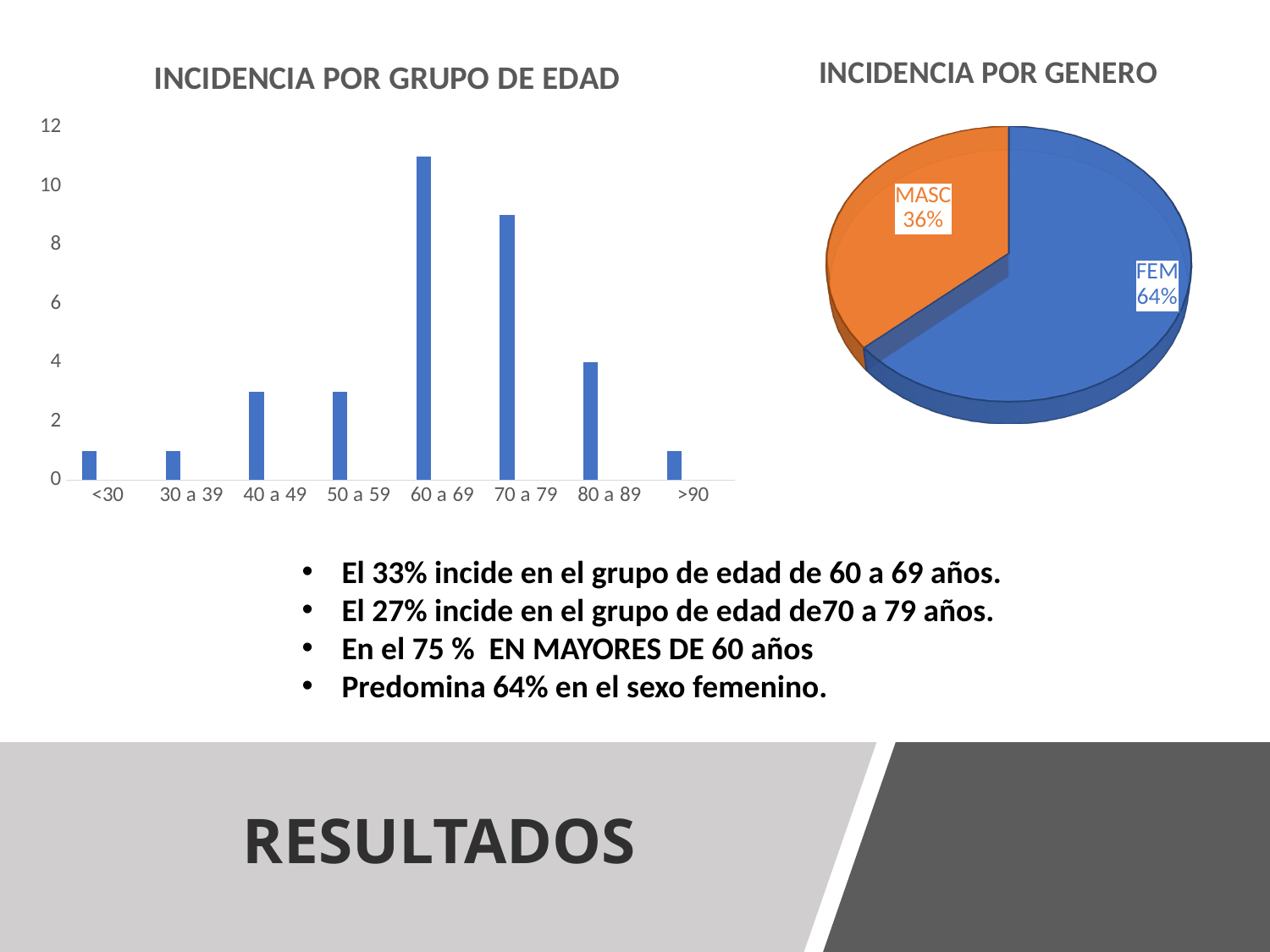
In the "INCIDENCIA POR GRUPO DE EDAD" chart, is the value for 40 a 49 greater or less than 2? greater What kind of chart is "INCIDENCIA POR GRUPO DE EDAD"? bar chart In the "INCIDENCIA POR GENERO" pie chart, what share does MASC have? 36% In the "INCIDENCIA POR GRUPO DE EDAD" chart, which age group has the highest value? 60 a 69 In the "INCIDENCIA POR GRUPO DE EDAD" chart, what is the value for 80 a 89? 4 In the "INCIDENCIA POR GENERO" pie chart, which slice is the largest? FEM What kind of chart is "INCIDENCIA POR GENERO"? pie chart In the "INCIDENCIA POR GRUPO DE EDAD" chart, which is larger, the value for 60 a 69 or the value for 70 a 79? 60 a 69 In the "INCIDENCIA POR GRUPO DE EDAD" chart, is the value for 60 a 69 greater or less than 10? greater In the "INCIDENCIA POR GRUPO DE EDAD" chart, how many age groups are shown on the x axis? 8 In the "INCIDENCIA POR GRUPO DE EDAD" chart, is the value for 70 a 79 greater or less than 10? less In the "INCIDENCIA POR GENERO" pie chart, what share does FEM have? 64%